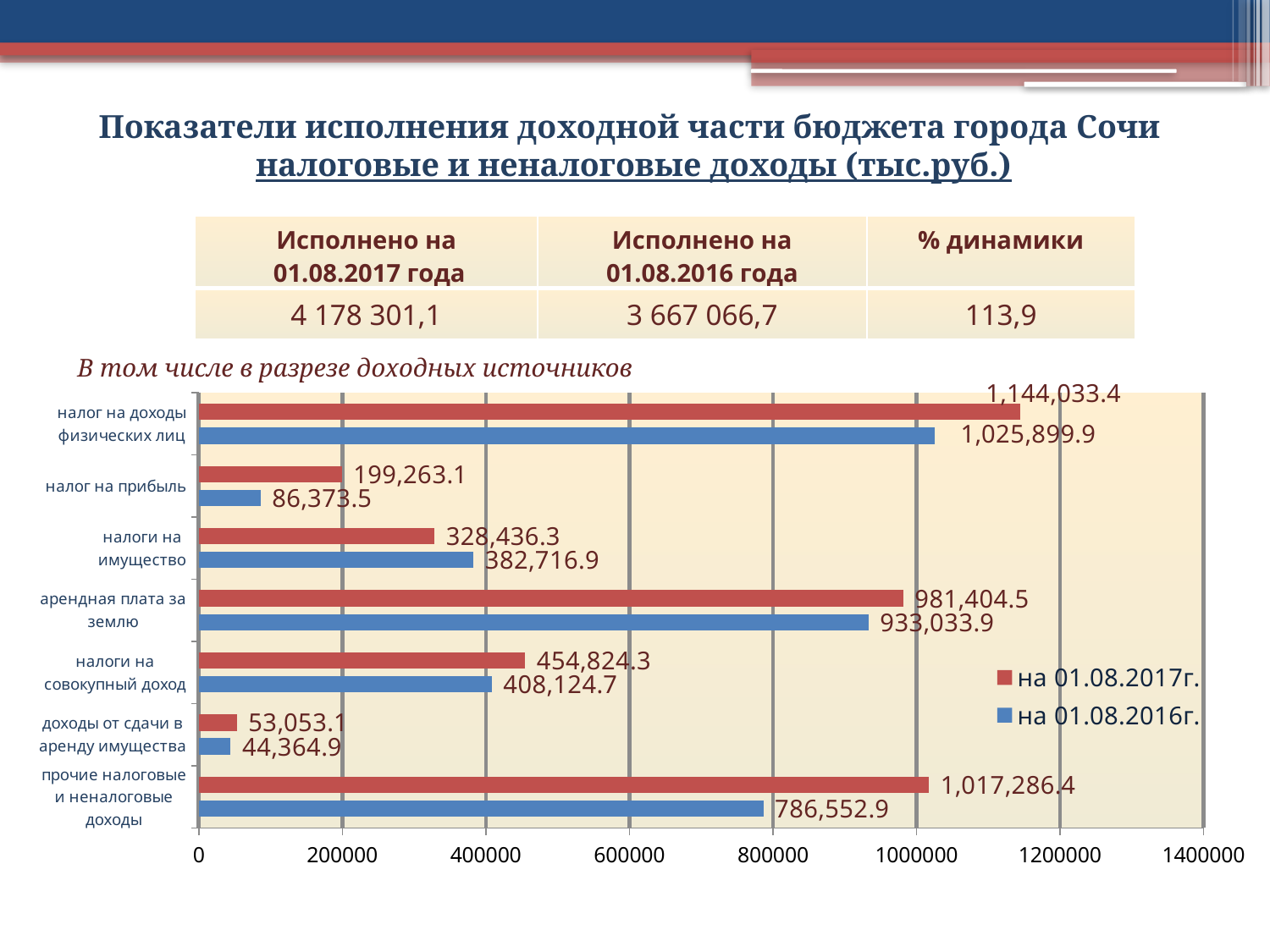
How many income source categories are plotted in the chart? 7 What colour are the bars for the series на 01.08.2017г.? red Which category has the highest value for the series на 01.08.2016г.? налог на доходы физических лиц For налоги на имущество, which series has the larger value: на 01.08.2017г. or на 01.08.2016г.? на 01.08.2016г. Which category has the lowest value for the series на 01.08.2017г.? доходы от сдачи в аренду имущества What is the value for налог на доходы физических лиц for the series на 01.08.2017г.? 1,144,033.4 What is the value for прочие налоговые и неналоговые доходы for the series на 01.08.2017г.? 1,017,286.4 Is the value for арендная плата за землю for the series на 01.08.2016г. greater or less than 800000? greater What is the value for налог на прибыль for the series на 01.08.2016г.? 86,373.5 What type of chart is shown on the slide? bar chart How many series does the chart legend list? 2 What is the difference between the 2017 and 2016 values for налог на доходы физических лиц? 118,133.5